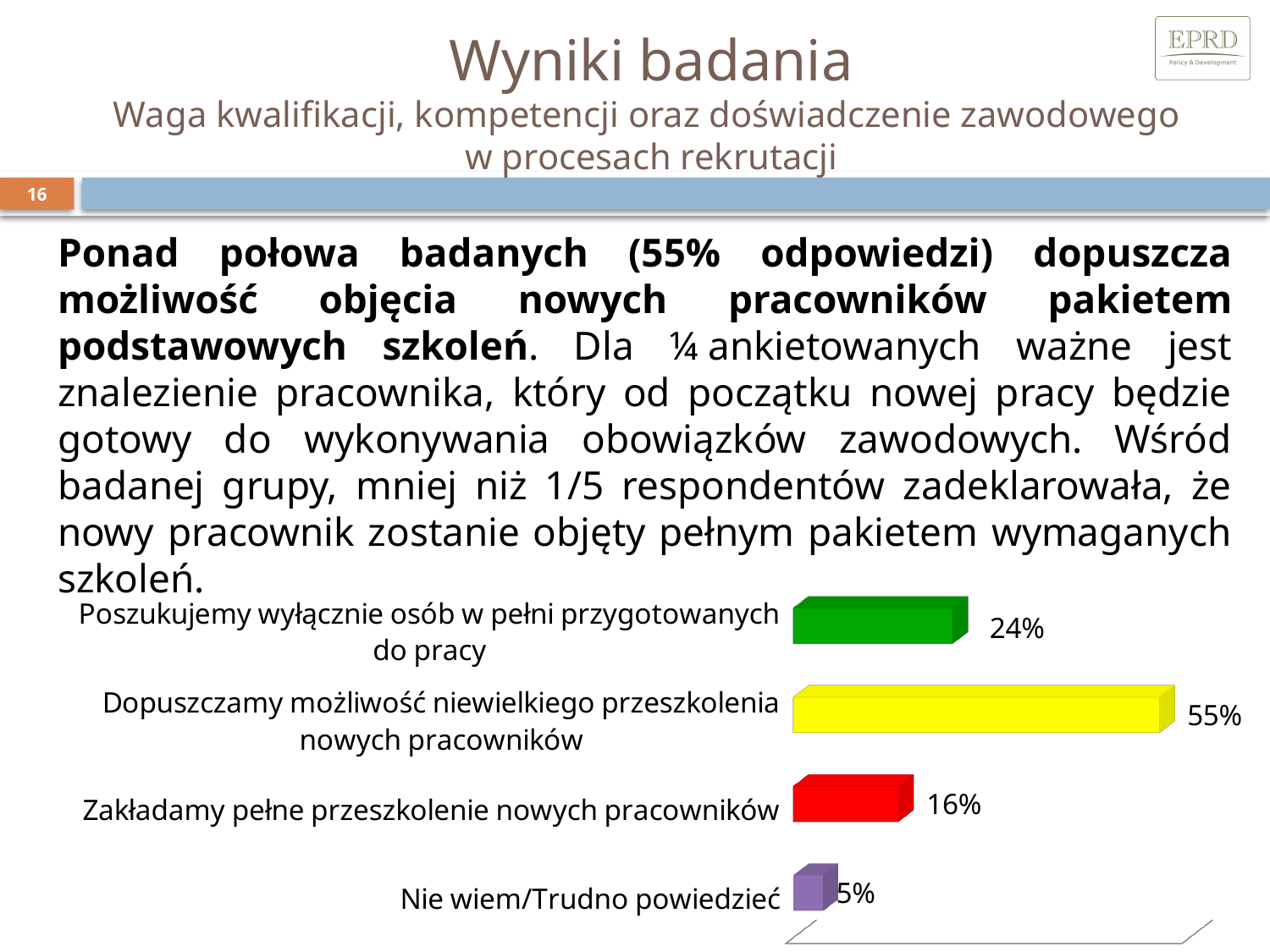
Which category has the highest value? Dopuszczamy możliwość niewielkiego przeszkolenia nowych pracowników Which category has the lowest value? Nie wiem/Trudno powiedzieć What is the value for "Dopuszczamy możliwość niewielkiego przeszkolenia nowych pracowników"? 55% Which is larger: the value for "Poszukujemy wyłącznie osób w pełni przygotowanych do pracy" or for "Zakładamy pełne przeszkolenie nowych pracowników"? Poszukujemy wyłącznie osób w pełni przygotowanych do pracy What is the difference between the values for "Dopuszczamy możliwość niewielkiego przeszkolenia nowych pracowników" and "Poszukujemy wyłącznie osób w pełni przygotowanych do pracy"? 31% What is the value for "Nie wiem/Trudno powiedzieć"? 5% What is the value for "Poszukujemy wyłącznie osób w pełni przygotowanych do pracy"? 24% What kind of chart is shown on the slide? Bar chart What is the difference between the values for "Zakładamy pełne przeszkolenie nowych pracowników" and "Nie wiem/Trudno powiedzieć"? 11% What colour is the bar for "Dopuszczamy możliwość niewielkiego przeszkolenia nowych pracowników"? Yellow What is the value for "Zakładamy pełne przeszkolenie nowych pracowników"? 16% How many categories does the chart show? 4